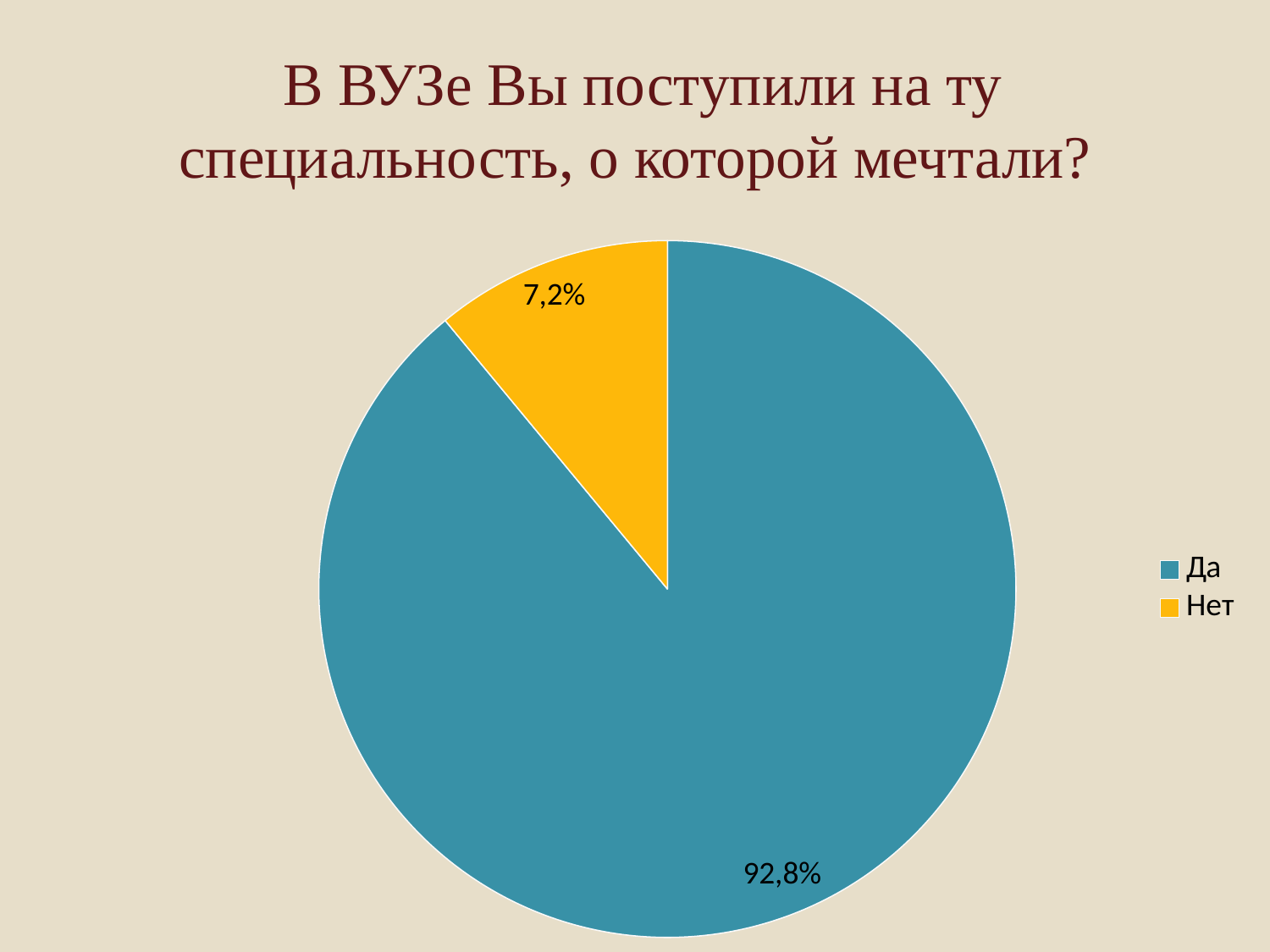
Which category has the largest slice of the pie? Да How many entries does the legend list? 2 What share of the pie does "Нет" take? 7,2% Which category has the smallest slice of the pie? Нет Which is larger, the share for "Да" or the share for "Нет"? Да How many categories does the pie chart have? 2 What kind of chart is shown on the slide? pie chart What is the title of the slide above the chart? В ВУЗе Вы поступили на ту специальность, о которой мечтали? What colour is the slice for "Нет"? yellow What share of the pie does "Да" take? 92,8% What is the difference between the shares for "Да" and "Нет"? 85,6%